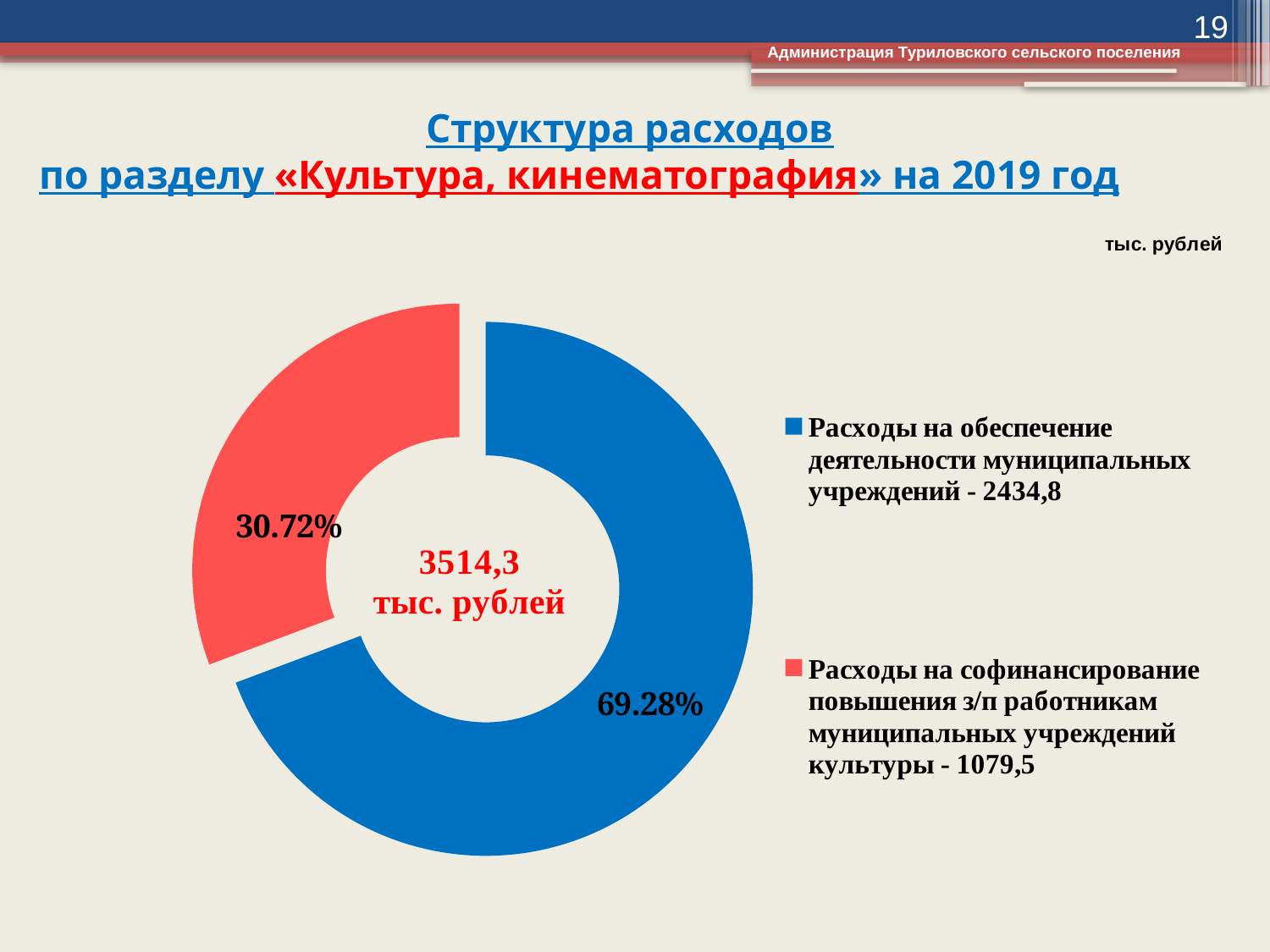
What is the value shown in the legend for «Расходы на обеспечение деятельности муниципальных учреждений»? 2434,8 What colour is the slice for «Расходы на софинансирование повышения з/п работникам муниципальных учреждений культуры»? Red What is the difference in percentage points between the two slices of the chart? 38.56% Which is larger: the slice for «Расходы на обеспечение деятельности муниципальных учреждений» or the slice for «Расходы на софинансирование повышения з/п работникам муниципальных учреждений культуры»? Расходы на обеспечение деятельности муниципальных учреждений What total is printed in the centre of the doughnut chart? 3514,3 тыс. рублей What is the value shown in the legend for «Расходы на софинансирование повышения з/п работникам муниципальных учреждений культуры»? 1079,5 Which category has the smallest slice of the chart? Расходы на софинансирование повышения з/п работникам муниципальных учреждений культуры What share of the chart does the slice for «Расходы на обеспечение деятельности муниципальных учреждений» represent? 69.28% What kind of chart is shown on the slide? Doughnut (pie) chart Which category has the largest slice of the chart? Расходы на обеспечение деятельности муниципальных учреждений How many categories does the chart show? 2 What share of the chart does the slice for «Расходы на софинансирование повышения з/п работникам муниципальных учреждений культуры» represent? 30.72%